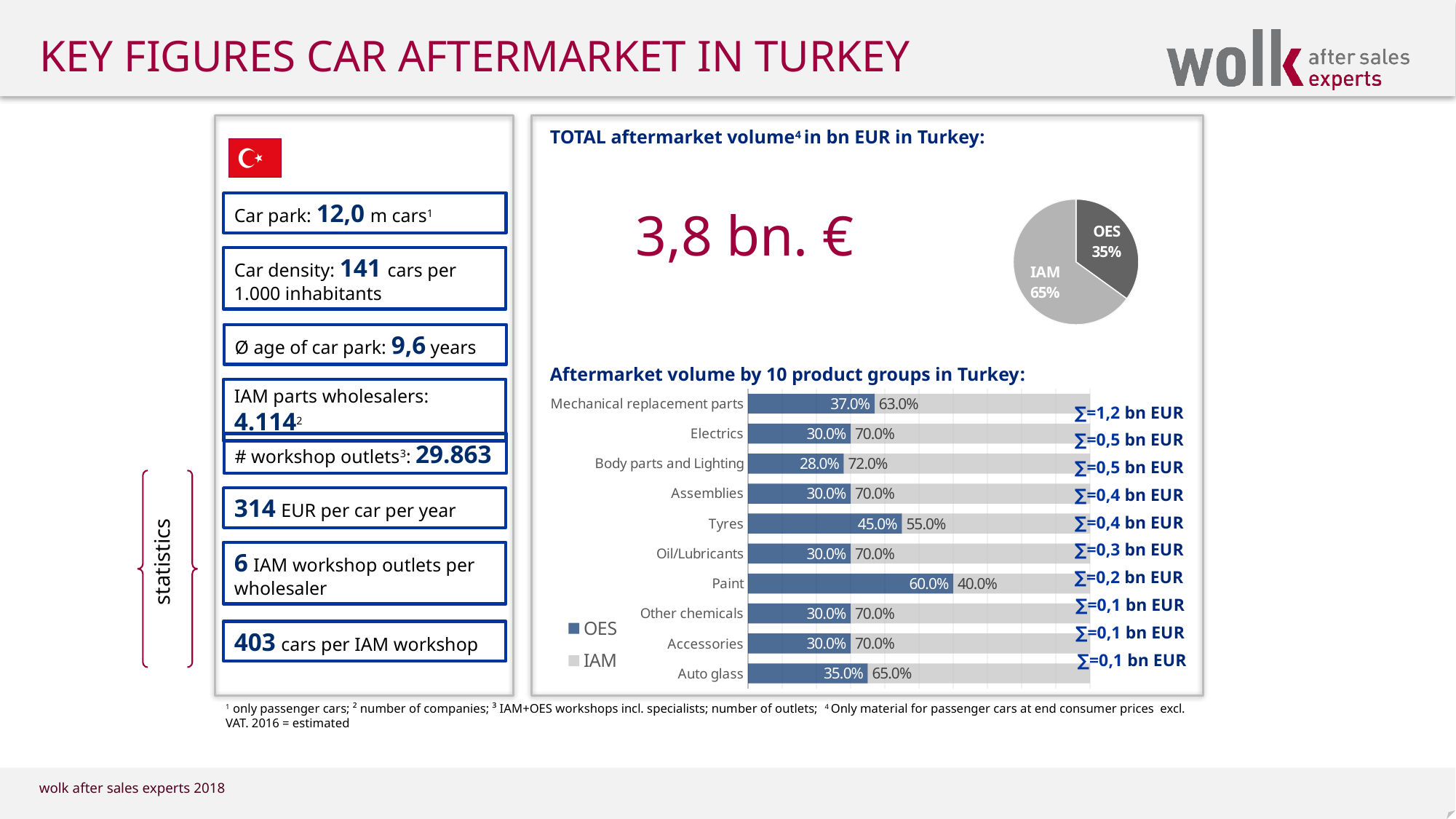
In the pie chart, what share does IAM hold? 65% In the bar chart of aftermarket volume by product groups, what is the IAM share for Body parts and Lighting? 72.0% In the bar chart of aftermarket volume by product groups, how many product groups are shown? 10 In the bar chart of aftermarket volume by product groups, which product group has the lowest OES share? Body parts and Lighting In the bar chart of aftermarket volume by product groups, what is the OES share for Tyres? 45.0% In the pie chart, what share does OES hold? 35% What type of chart is used to show aftermarket volume by 10 product groups? Stacked bar chart In the bar chart of aftermarket volume by product groups, what is the difference between the IAM share and the OES share for Mechanical replacement parts? 26.0% In the bar chart of aftermarket volume by product groups, which product group has the highest OES share? Paint In the pie chart, which segment is larger, IAM or OES? IAM In the bar chart of aftermarket volume by product groups, how many series does the legend list? 2 In the bar chart of aftermarket volume by product groups, what total volume in bn EUR is shown for Mechanical replacement parts? 1,2 bn EUR